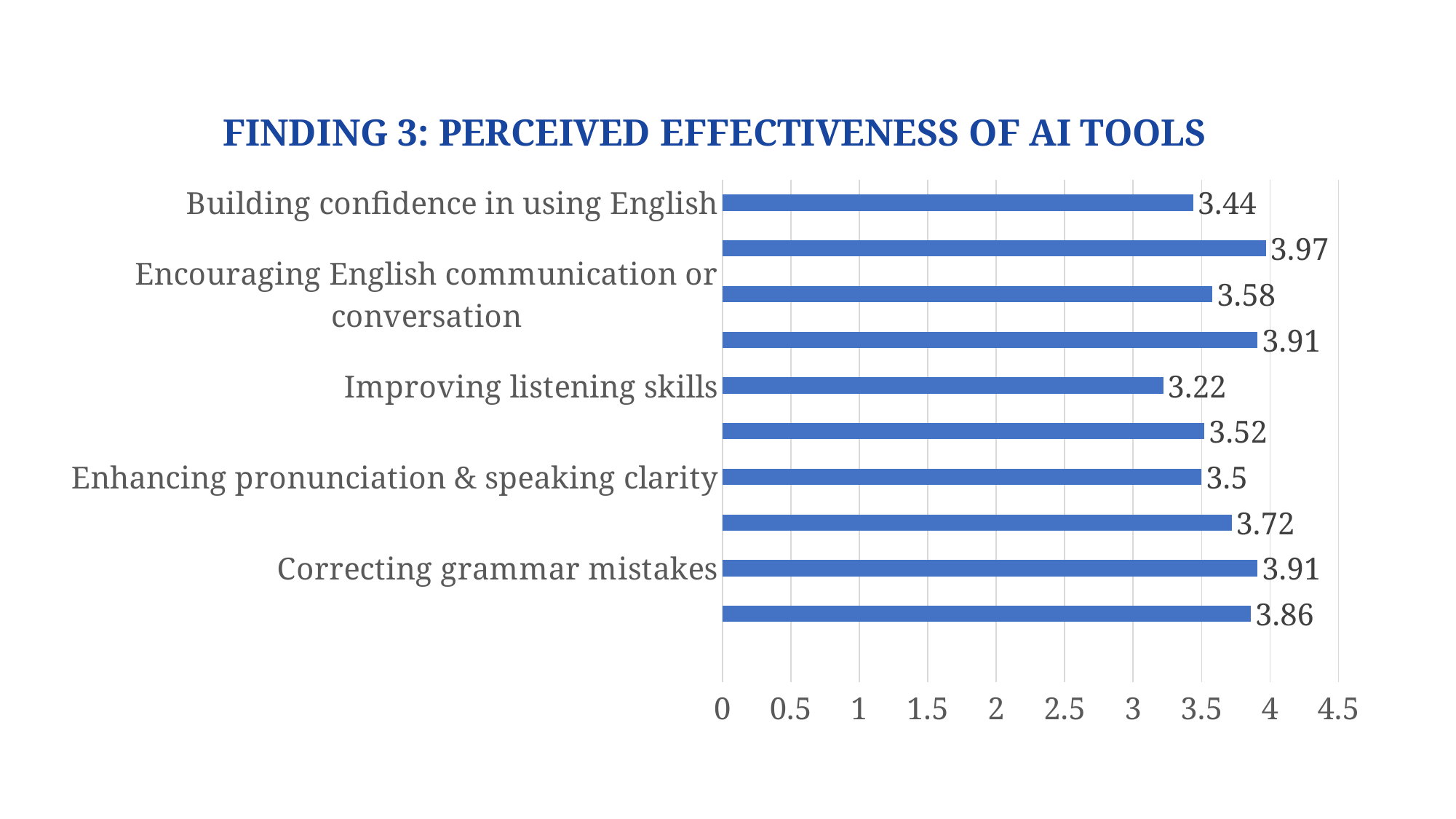
What kind of chart is shown on the slide? Bar chart What is the value for Building confidence in using English? 3.44 Is the value for Correcting grammar mistakes greater or less than 3.5? greater What is the value for Correcting grammar mistakes? 3.91 What is the value for Improving listening skills? 3.22 What is the title of the chart? FINDING 3: PERCEIVED EFFECTIVENESS OF AI TOOLS What is the difference between the values for Correcting grammar mistakes and Improving listening skills? 0.69 What is the value for Encouraging English communication or conversation? 3.58 Which is larger, the value for Building confidence in using English or the value for Encouraging English communication or conversation? Encouraging English communication or conversation Which labelled category has the lowest value? Improving listening skills How many bars are plotted in the chart? 10 What is the value for Enhancing pronunciation & speaking clarity? 3.5